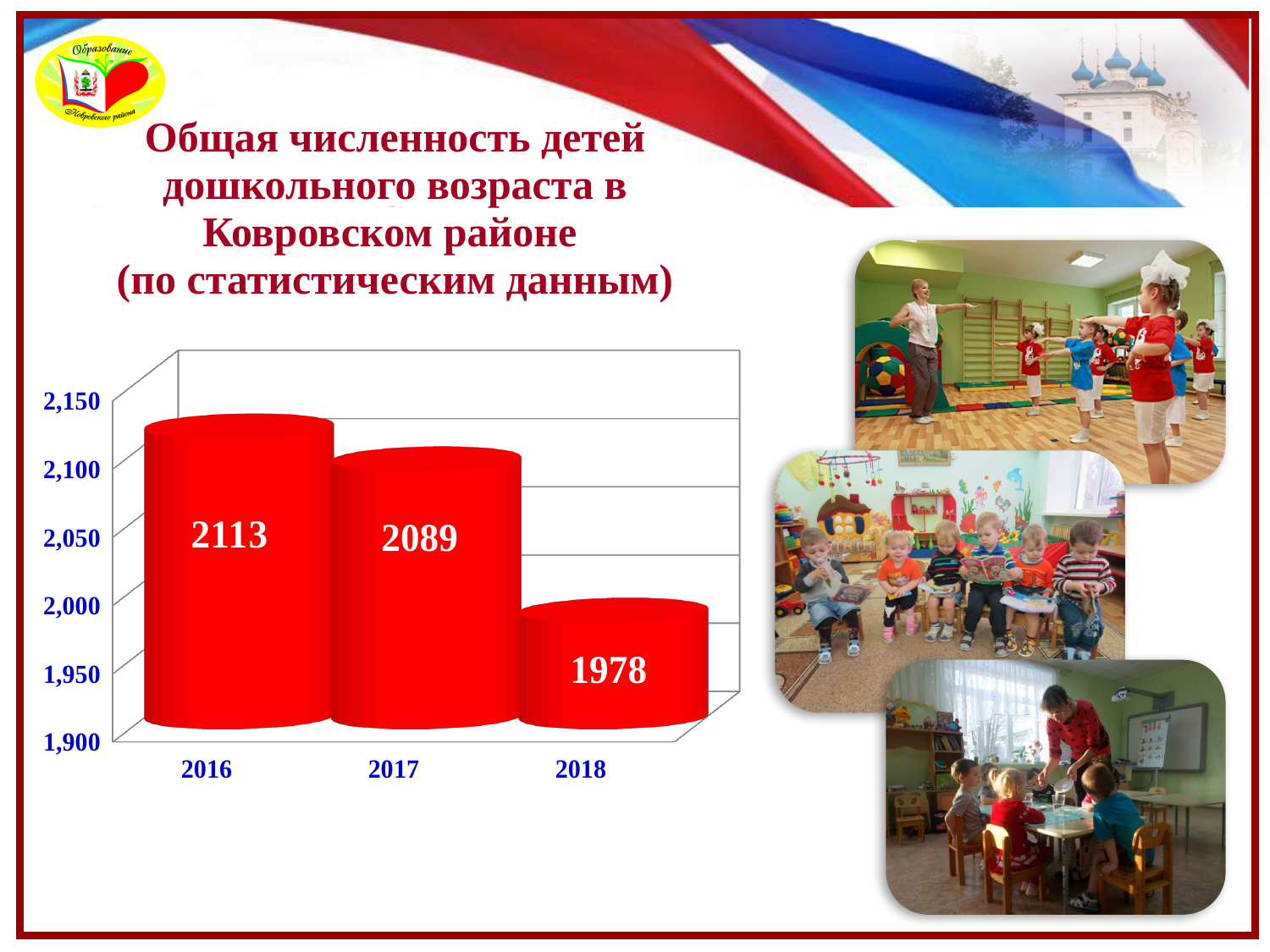
Which is larger, the value for 2016 or the value for 2017? 2016 What is the difference between the values for 2016 and 2018? 135 Which year has the lowest value? 2018 Is the value for 2018 greater or less than 2,000? less What is the difference between the values for 2017 and 2018? 111 What kind of chart is shown on the slide? bar chart How many years are shown on the chart? 3 Which year has the highest value? 2016 What is the value shown for 2018? 1978 Do the values rise or fall from 2016 to 2018? fall What is the value shown for 2017? 2089 What is the value shown for 2016? 2113